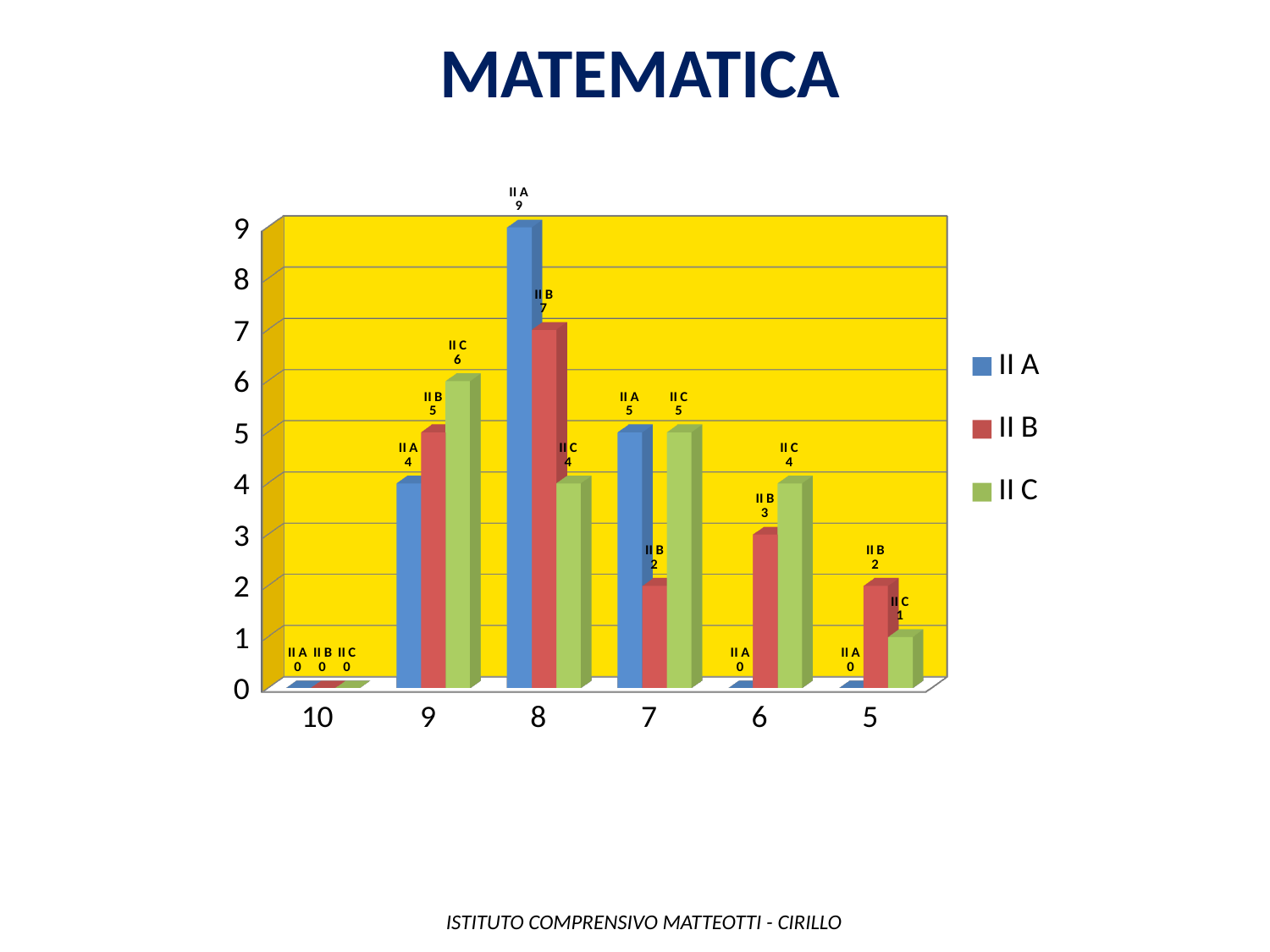
What is the value for II A at grade 8? 9 What is the value for II C at grade 5? 1 What kind of chart is shown on the slide? bar chart What is the value for II C at grade 9? 6 What is the difference between II A and II B at grade 8? 2 What is the value for II B at grade 6? 3 Which grade category has the lowest value for II B? 10 What is the title of the slide? MATEMATICA How many series does the legend list? 3 How many grade categories are shown on the x axis? 6 Which is larger at grade 7: II B or II C? II C Which grade category has the highest value for II A? 8